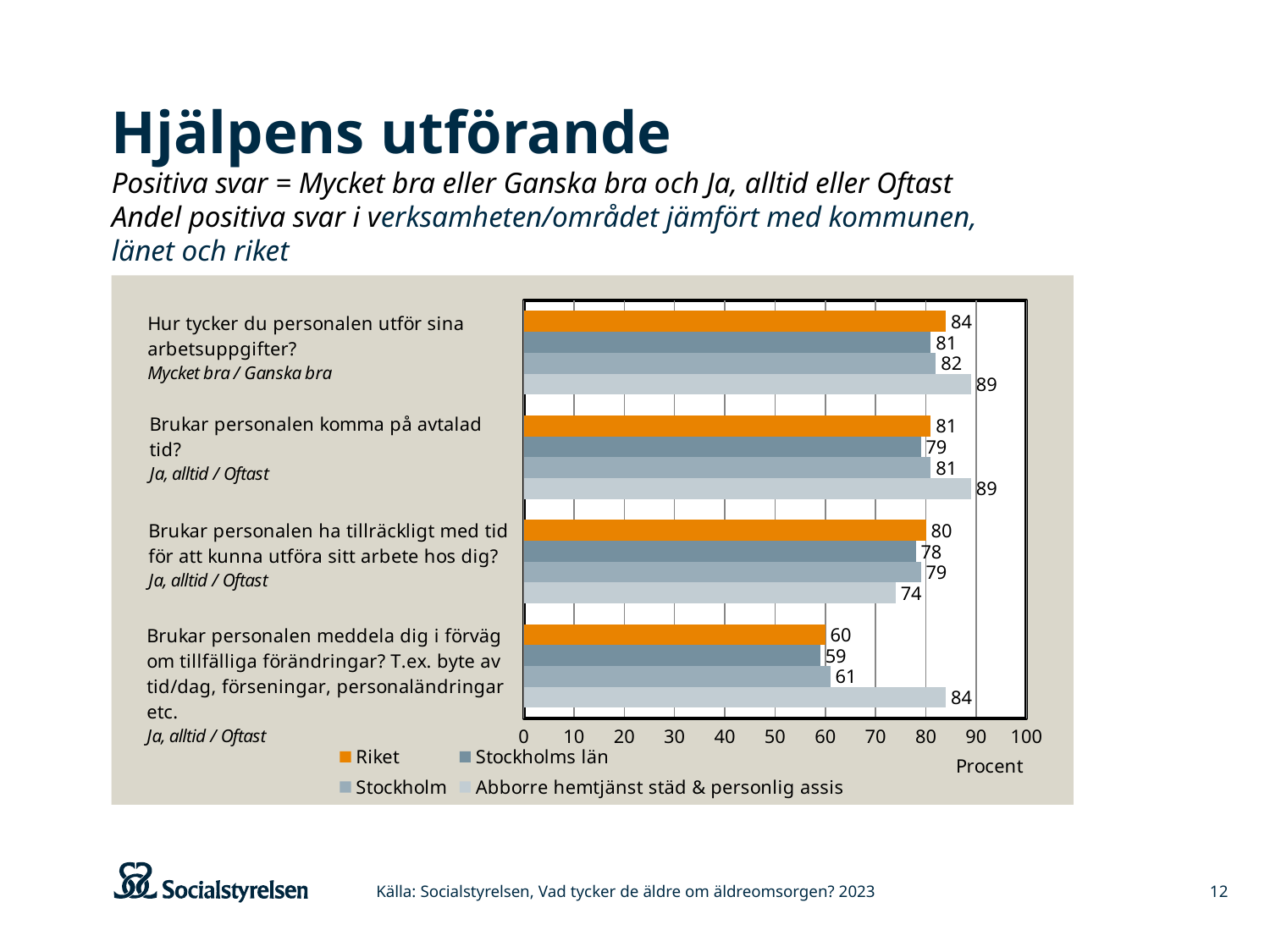
What is the difference between Abborre hemtjänst städ & personlig assis and Riket on the question "Brukar personalen meddela dig i förväg om tillfälliga förändringar?"? 24 What is the value for Stockholm on the question "Brukar personalen ha tillräckligt med tid för att kunna utföra sitt arbete hos dig?"? 79 On the question "Brukar personalen ha tillräckligt med tid för att kunna utföra sitt arbete hos dig?", which is larger: Riket or Abborre hemtjänst städ & personlig assis? Riket What is the value for Stockholms län on the question "Brukar personalen meddela dig i förväg om tillfälliga förändringar?"? 59 What is the label of the x axis? Procent What is the value for Abborre hemtjänst städ & personlig assis on the question "Brukar personalen komma på avtalad tid?"? 89 How many question categories are shown on the chart? 4 Which series has the lowest value on the question "Brukar personalen ha tillräckligt med tid för att kunna utföra sitt arbete hos dig?"? Abborre hemtjänst städ & personlig assis What is the value for Riket on the question "Hur tycker du personalen utför sina arbetsuppgifter?"? 84 How many series does the legend list? 4 Which series has the highest value on the question "Brukar personalen meddela dig i förväg om tillfälliga förändringar?"? Abborre hemtjänst städ & personlig assis What kind of chart is shown on the slide? Bar chart